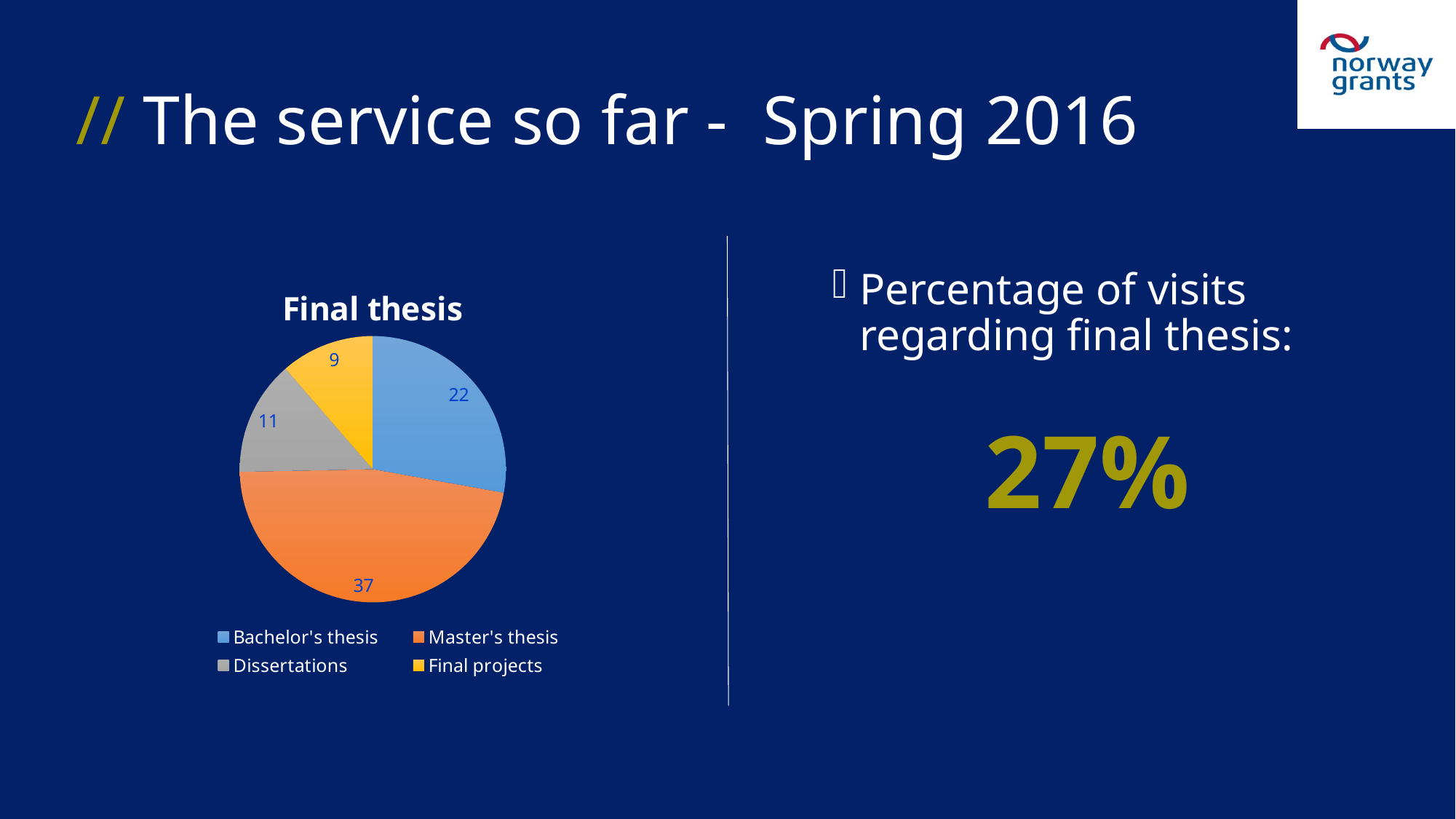
Which category has the smallest slice in the Final thesis pie chart? Final projects Which category has the largest slice in the Final thesis pie chart? Master's thesis What is the total of all slices in the Final thesis pie chart? 79 What is the difference between the values for Master's thesis and Bachelor's thesis? 15 What is the value for Final projects in the Final thesis pie chart? 9 What is the value for Bachelor's thesis in the Final thesis pie chart? 22 Which is larger, the value for Dissertations or the value for Final projects? Dissertations What is the value for Dissertations in the Final thesis pie chart? 11 What is the value for Master's thesis in the Final thesis pie chart? 37 How many categories does the Final thesis pie chart have? 4 What type of chart is shown on the slide? pie chart What is the title of the chart? Final thesis